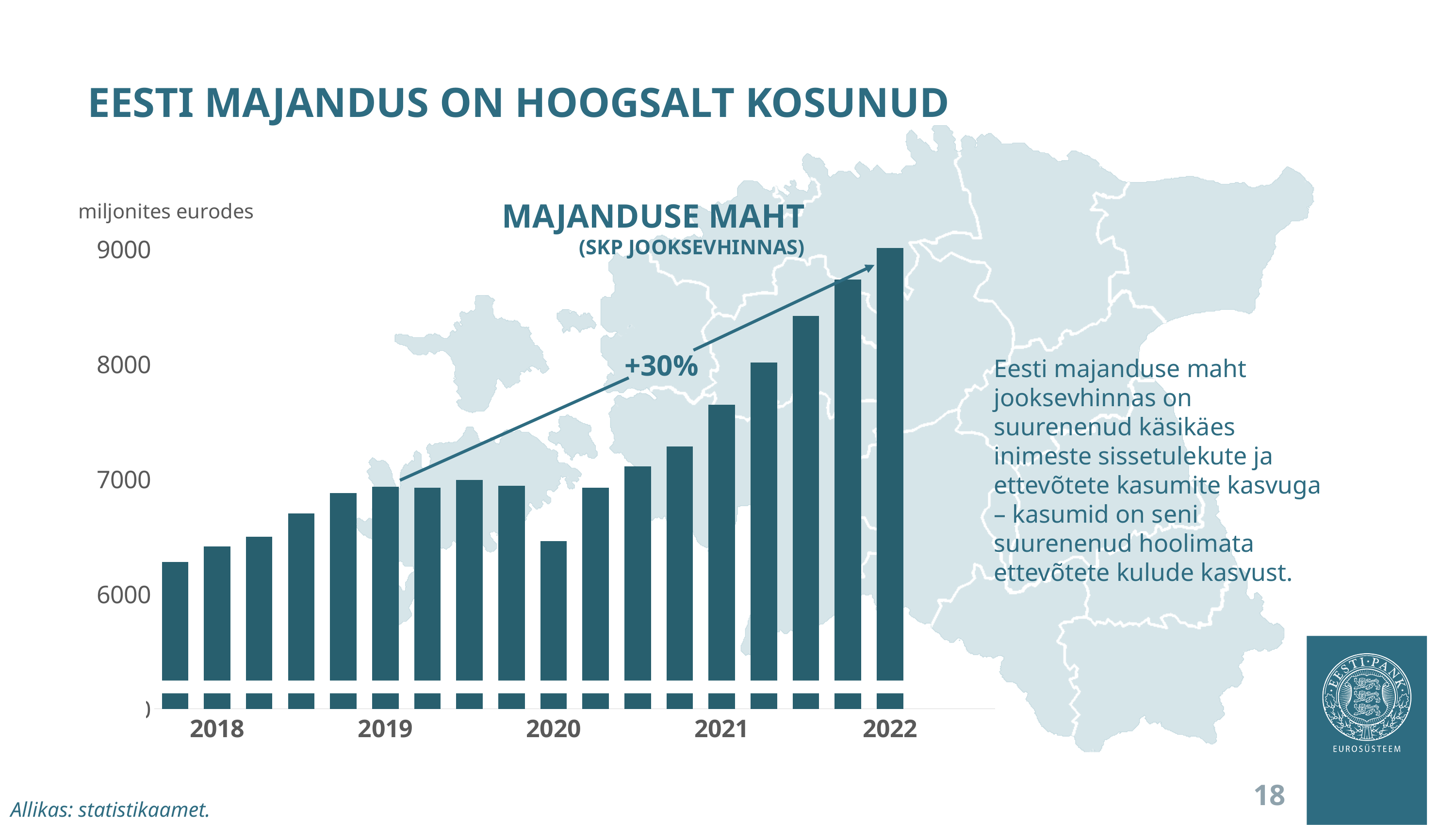
How many bars are plotted in the chart? 18 Is the value of the first bar of 2021 greater or less than 7000? greater What is the title of the chart? MAJANDUSE MAHT (SKP JOOKSEVHINNAS) Is the value of the last bar of 2021 greater or less than 9000? less In what unit are the values on the chart expressed? miljonites eurodes Which year contains the shortest bar in the chart? 2018 What kind of chart is shown on the slide? bar chart Which year contains the tallest bar in the chart? 2022 Which is larger: the first bar of 2018 or the first bar of 2020? the first bar of 2020 Is the value of the first bar (2018) greater or less than 7000? less Do the bar values generally rise or fall from 2018 to 2022? rise